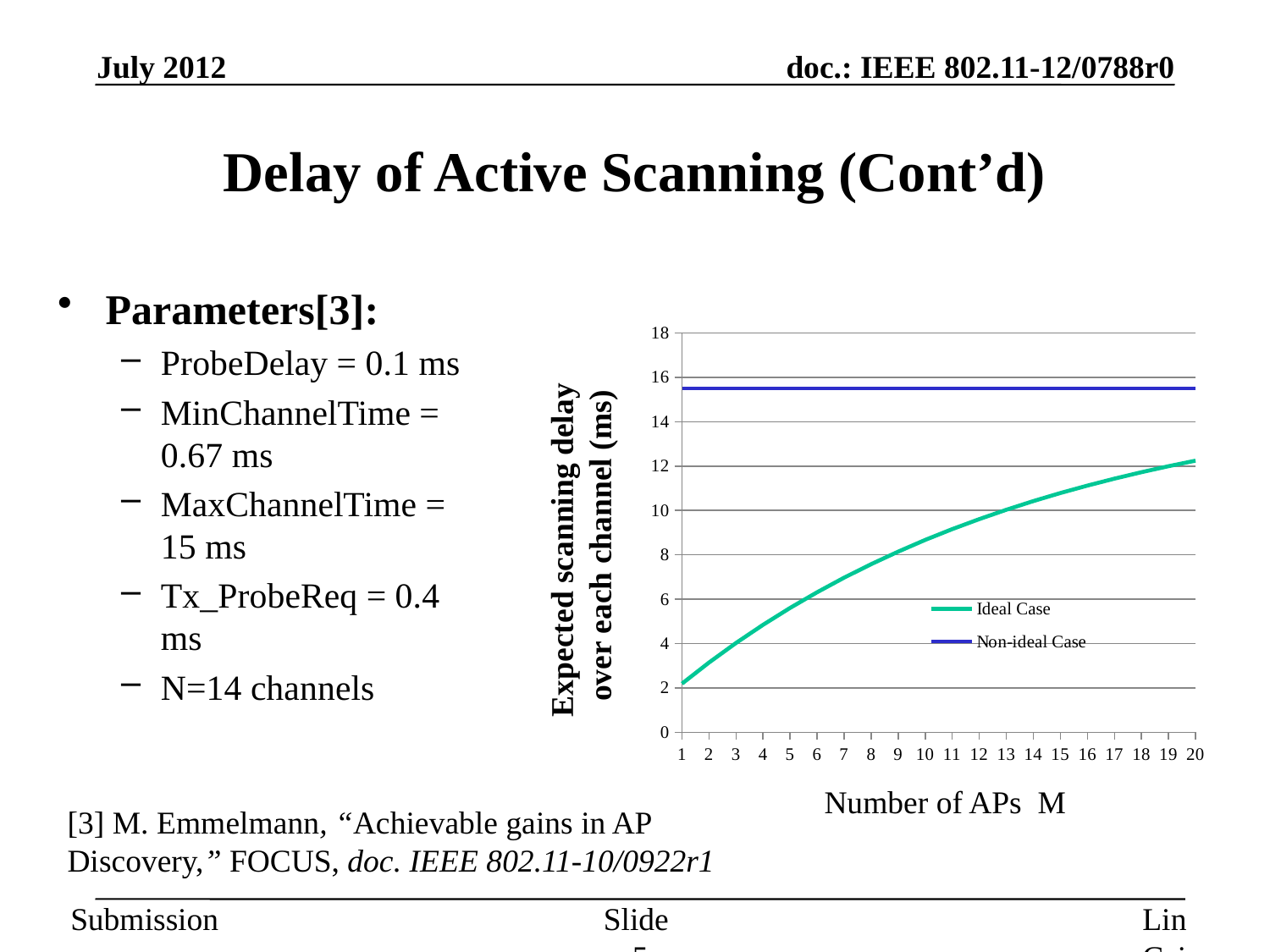
What kind of chart is shown on the slide? line chart What are the two series named in the chart legend? Ideal Case and Non-ideal Case At M = 20, which series has the larger expected scanning delay, Ideal Case or Non-ideal Case? Non-ideal Case What is the label of the y axis of the chart? Expected scanning delay over each channel (ms) Does the Ideal Case line rise or fall as the number of APs M increases? rises Is the Ideal Case value at M = 1 greater or less than 4? less Is the Ideal Case value at M = 5 greater or less than 8? less Is the Ideal Case value at M = 20 greater or less than 10? greater How many values of M (number of APs) are plotted along the x axis? 20 Does the Non-ideal Case line rise, fall, or stay flat as the number of APs M increases? stays flat How many series does the chart legend list? 2